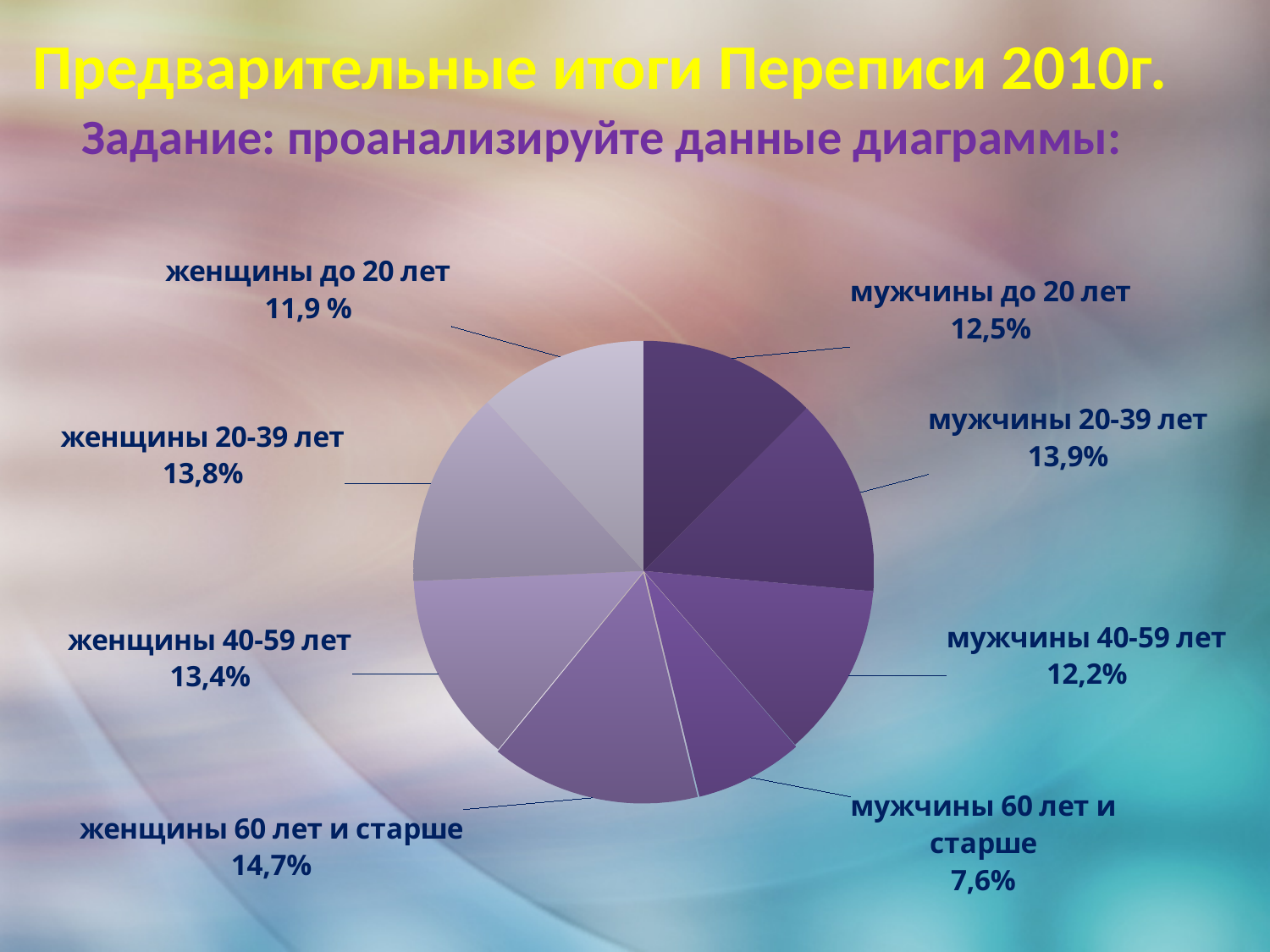
What is the value for "мужчины 60 лет и старше"? 7,6% Which category has the largest share of the pie? женщины 60 лет и старше What kind of chart is shown on the slide? pie chart What is the value for "мужчины до 20 лет"? 12,5% What is the value for "женщины 20-39 лет"? 13,8% What is the title of the slide above the chart? Предварительные итоги Переписи 2010г. What is the difference between the values for "женщины 60 лет и старше" and "мужчины 60 лет и старше"? 7,1% What is the combined share of all four "мужчины" categories? 46,2% Which category has the smallest share of the pie? мужчины 60 лет и старше Which is larger: the value for "женщины 40-59 лет" or "мужчины 40-59 лет"? женщины 40-59 лет How many slices does the pie chart have? 8 What is the value for "женщины 60 лет и старше"? 14,7%